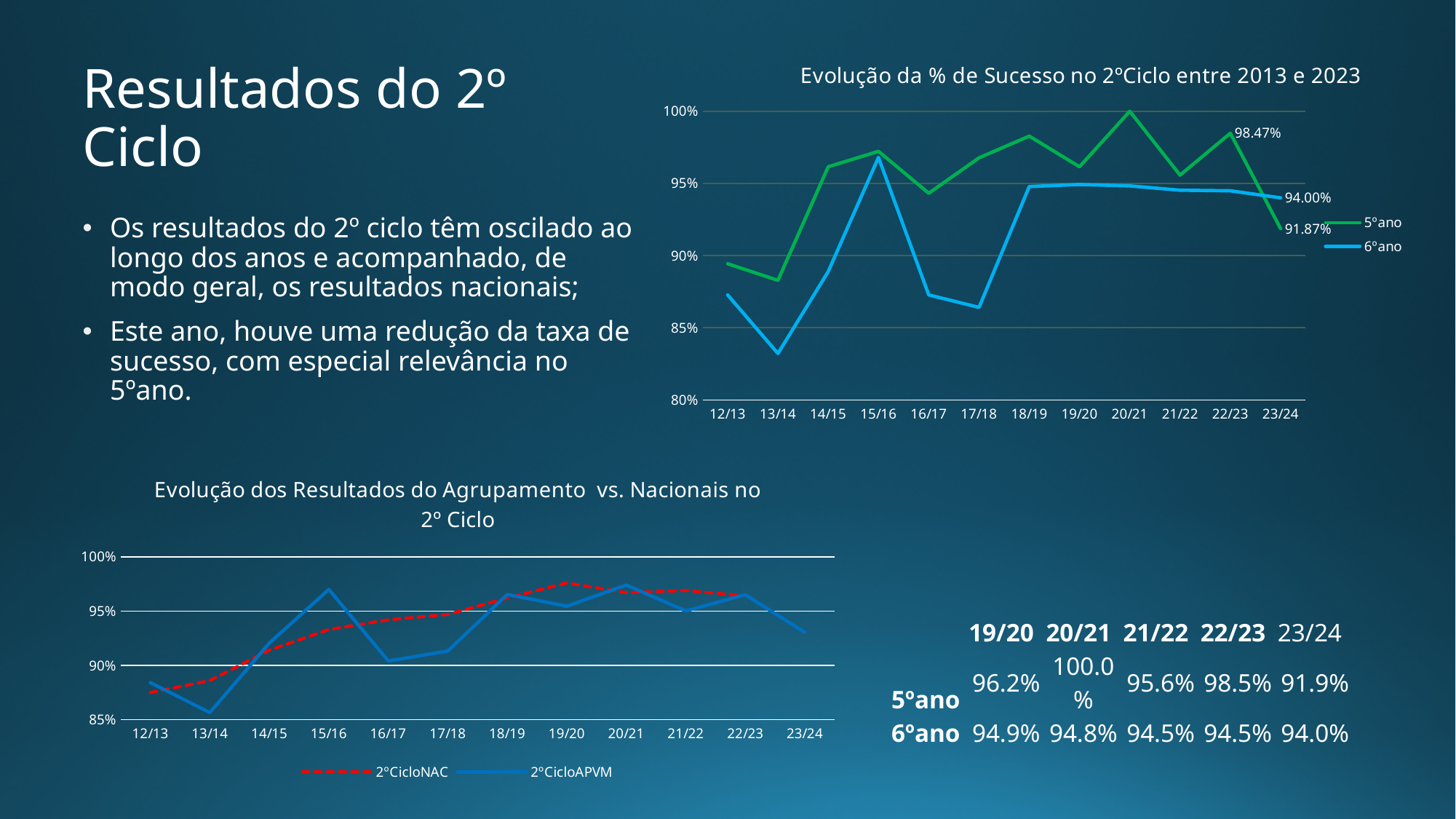
What kind of chart is the bottom chart 'Evolução dos Resultados do Agrupamento vs. Nacionais no 2º Ciclo'? Line chart In the top chart 'Evolução da % de Sucesso no 2ºCiclo entre 2013 e 2023', what is the value for 5ºano in 23/24? 91.87% In the bottom chart 'Evolução dos Resultados do Agrupamento vs. Nacionais no 2º Ciclo', is the value for 2ºCicloAPVM in 13/14 greater or less than 90%? less In the top chart 'Evolução da % de Sucesso no 2ºCiclo entre 2013 e 2023', what is the value for 6ºano in 23/24? 94.00% In the top chart 'Evolução da % de Sucesso no 2ºCiclo entre 2013 e 2023', in which year does 6ºano reach its lowest value? 13/14 In the top chart 'Evolução da % de Sucesso no 2ºCiclo entre 2013 e 2023', by how many percentage points did 5ºano fall from 22/23 to 23/24? 6.6 percentage points In the top chart 'Evolução da % de Sucesso no 2ºCiclo entre 2013 e 2023', what is the value for 5ºano in 22/23? 98.47% In the top chart 'Evolução da % de Sucesso no 2ºCiclo entre 2013 e 2023', how many series does the legend list? 2 In the bottom chart 'Evolução dos Resultados do Agrupamento vs. Nacionais no 2º Ciclo', which series is drawn as a red dashed line? 2ºCicloNAC In the top chart 'Evolução da % de Sucesso no 2ºCiclo entre 2013 e 2023', in which year does 5ºano reach its highest value? 20/21 In the top chart 'Evolução da % de Sucesso no 2ºCiclo entre 2013 e 2023', which series has the higher value in 23/24, 5ºano or 6ºano? 6ºano In the top chart 'Evolução da % de Sucesso no 2ºCiclo entre 2013 e 2023', how many school years are shown on the x axis? 12